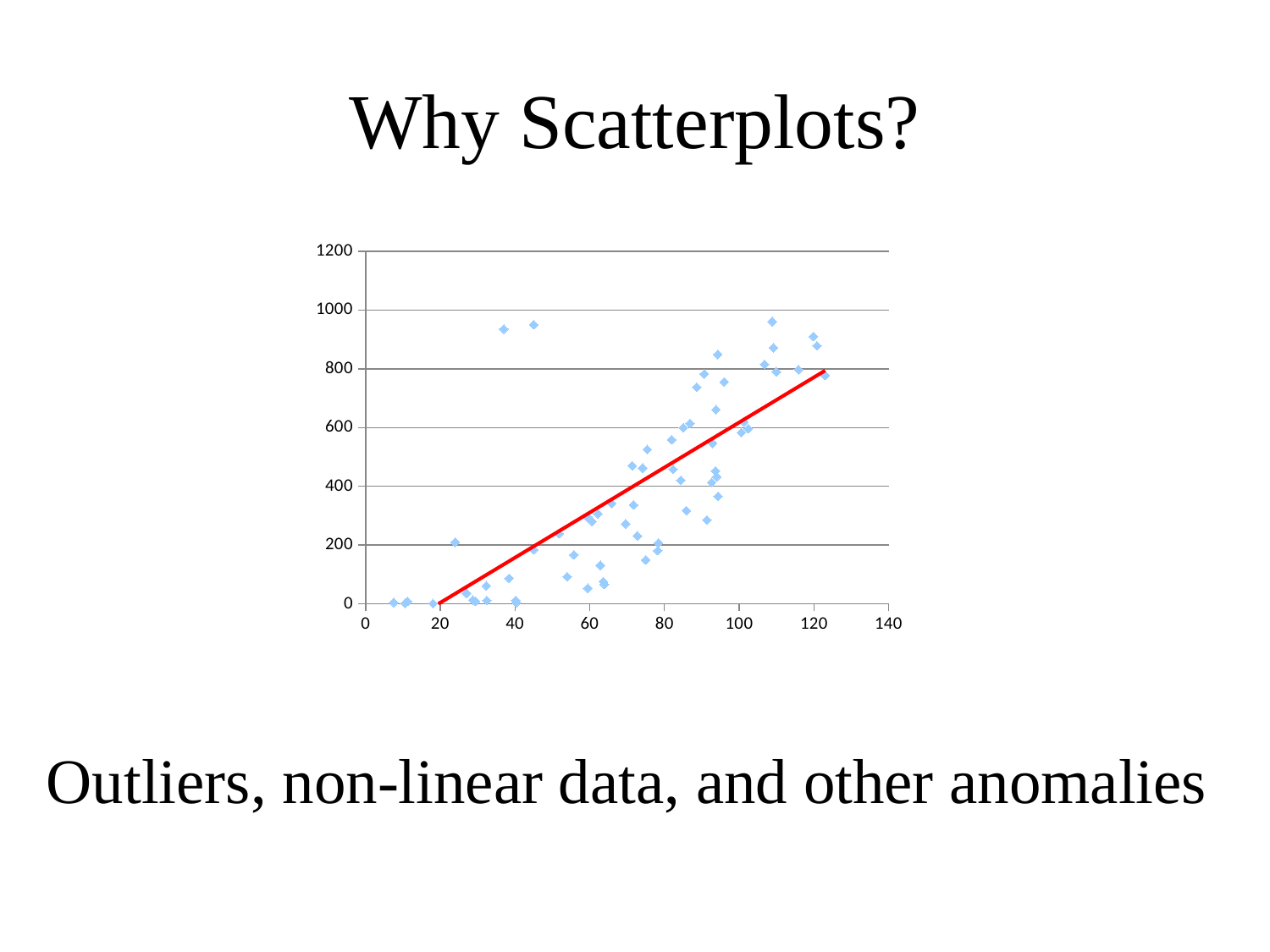
Do the plotted values generally rise or fall as the x value increases? rise Is the value of the red trend line at x = 20 greater or less than 200? less What kind of chart is shown on the slide? scatter plot What is the highest tick value shown on the y axis? 1200 What colour is the trend line drawn through the points? red Do any plotted points lie above the 1000 gridline? No Is the y value of the highest plotted point greater or less than 1000? less